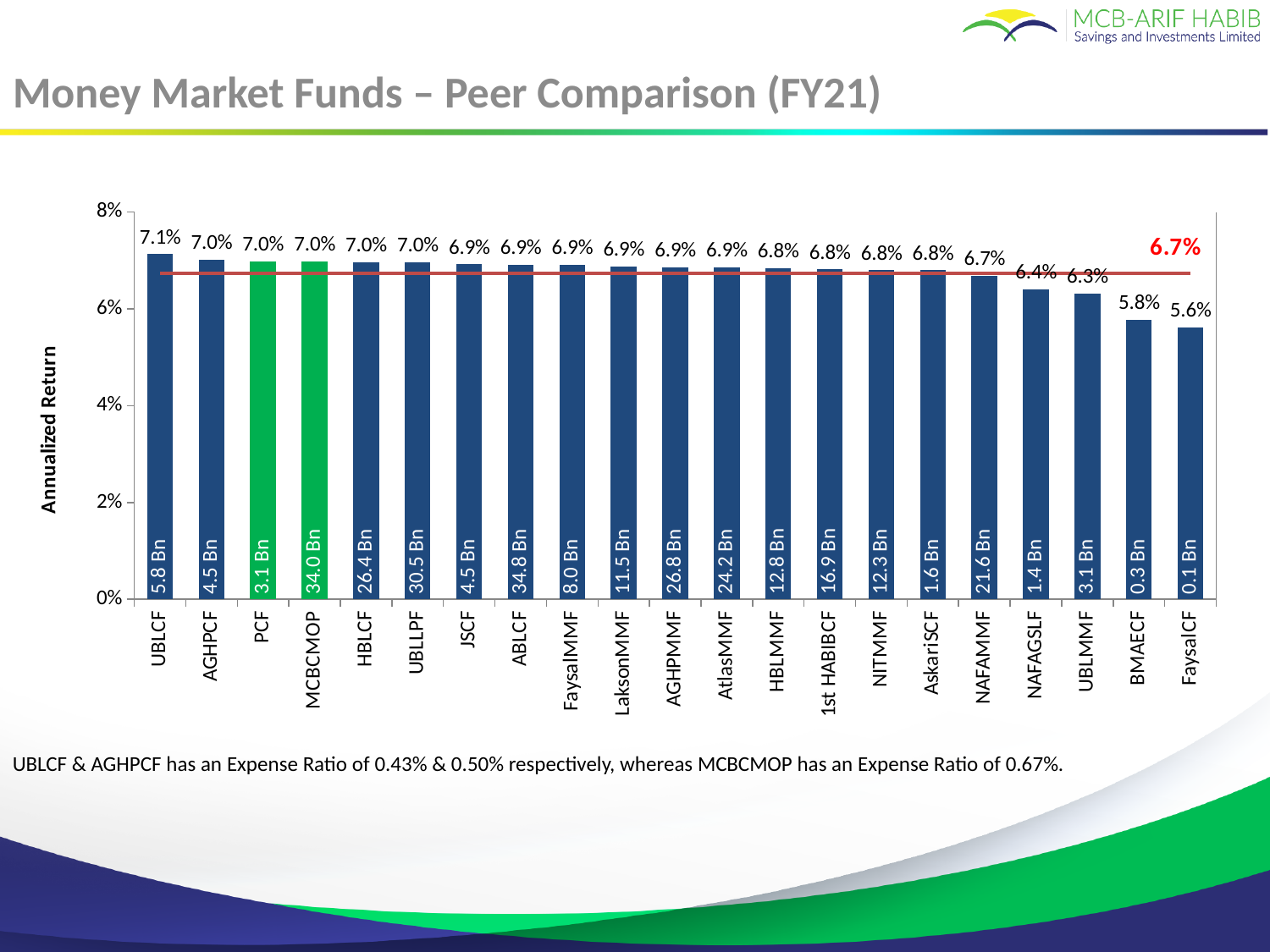
Which has the higher annualized return, UBLMMF or BMAECF? UBLMMF What kind of chart is shown on the slide? Bar chart Which fund has the lowest annualized return on the chart? FaysalCF Do the annualized returns rise or fall moving from left to right along the x axis? Fall What is the difference between the annualized returns of UBLCF and FaysalCF? 1.5 percentage points What is the annualized return shown for UBLCF? 7.1% How many funds are shown on the chart? 21 What fund size label is printed inside the MCBCMOP bar? 34.0 Bn Is the annualized return for FaysalCF greater or less than 6%? less What is the annualized return shown for NAFAGSLF? 6.4% What value is labelled on the red horizontal line across the chart? 6.7% Which fund has the highest annualized return on the chart? UBLCF